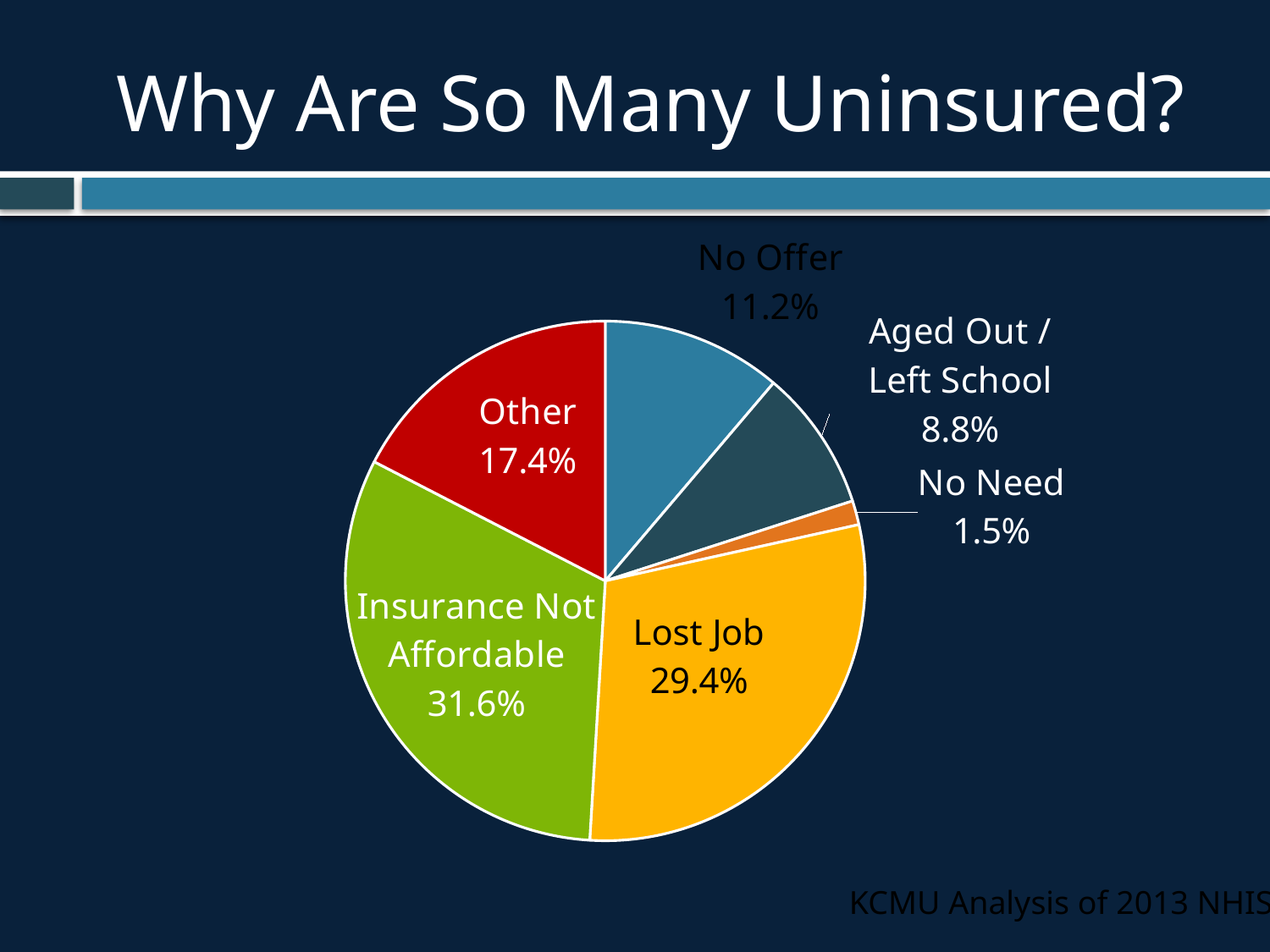
What kind of chart is shown on the slide? Pie chart How many slices does the pie chart have? 6 Which slice of the pie is the largest? Insurance Not Affordable What is the difference in percentage points between Other and Aged Out / Left School? 8.6 Which slice of the pie is the smallest? No Need What is the title of the slide containing the pie chart? Why Are So Many Uninsured? What share of the pie is labelled Insurance Not Affordable? 31.6% What percentage is shown for Lost Job? 29.4% Which is larger, Other or No Offer? Other What is the difference in percentage points between Insurance Not Affordable and Lost Job? 2.2 What percentage is shown for No Offer? 11.2% What percentage is shown for Aged Out / Left School? 8.8%